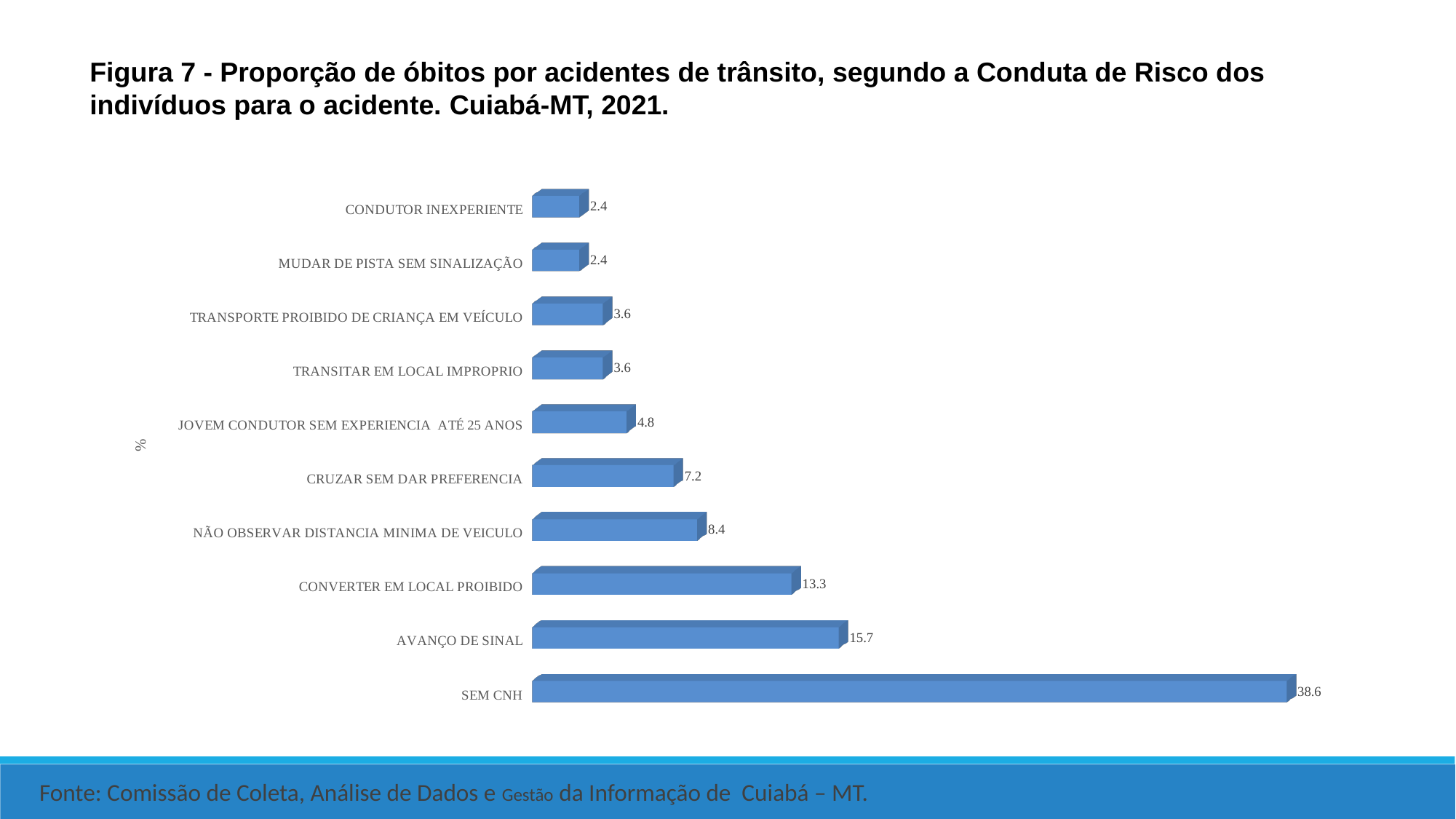
What is the value for SEM CNH? 38.6 Which category has the highest value? SEM CNH What is the difference between the values for NÃO OBSERVAR DISTANCIA MINIMA DE VEICULO and JOVEM CONDUTOR SEM EXPERIENCIA ATÉ 25 ANOS? 3.6 What is the difference between the values for SEM CNH and AVANÇO DE SINAL? 22.9 Which is larger, the value for CONVERTER EM LOCAL PROIBIDO or the value for NÃO OBSERVAR DISTANCIA MINIMA DE VEICULO? CONVERTER EM LOCAL PROIBIDO What is the value for CONVERTER EM LOCAL PROIBIDO? 13.3 What kind of chart is shown on the slide? Bar chart What label is shown on the vertical axis of the chart? % What is the value for AVANÇO DE SINAL? 15.7 How many categories are shown in the chart? 10 What is the value for CRUZAR SEM DAR PREFERENCIA? 7.2 What is the value for TRANSITAR EM LOCAL IMPROPRIO? 3.6